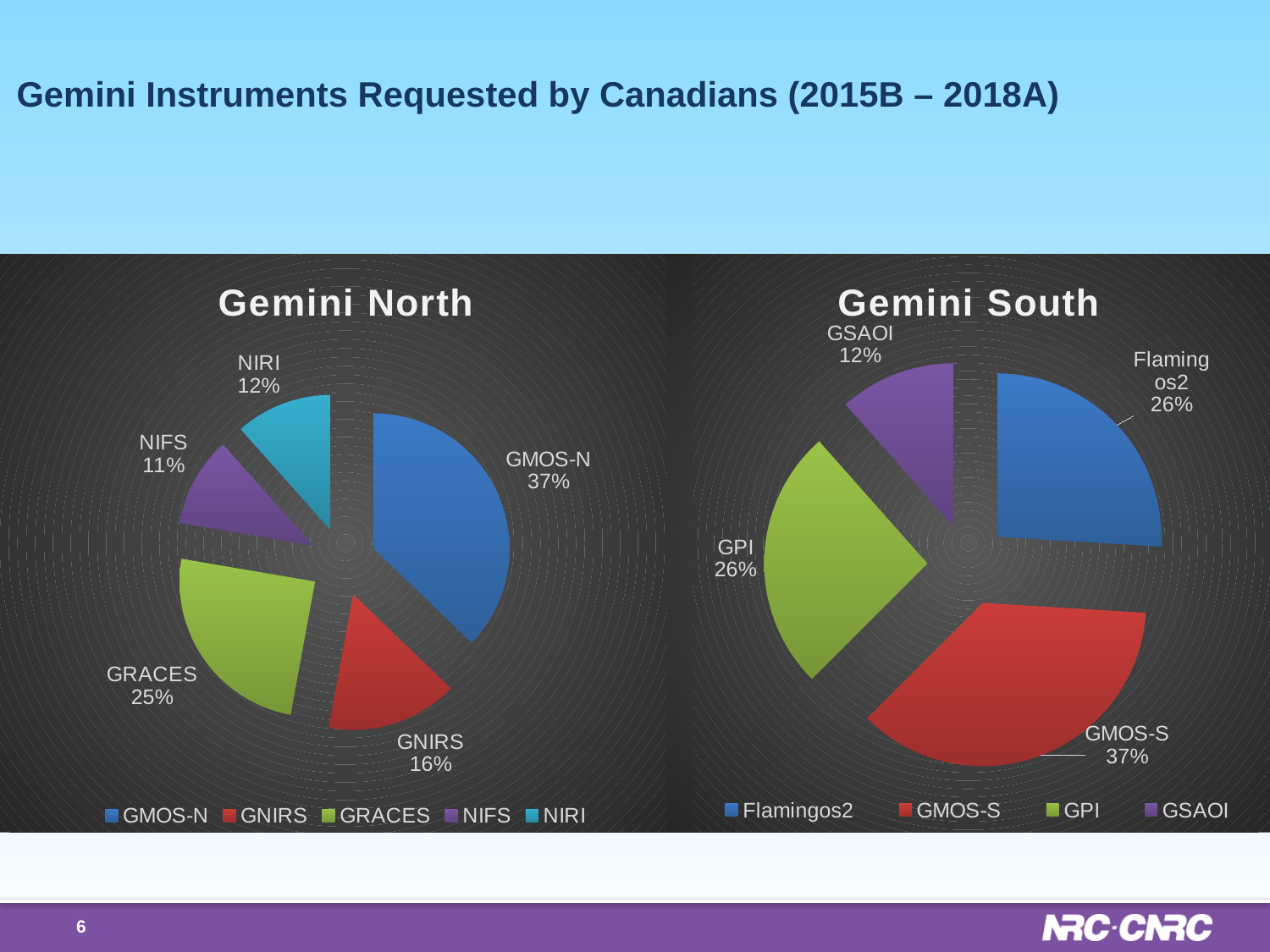
In the Gemini South chart, how many instruments does the legend list? 4 In the Gemini North chart, what share does GMOS-N have? 37% In the Gemini South chart, which instrument has the largest share? GMOS-S In the Gemini South chart, what share does GSAOI have? 12% In the Gemini North chart, what is the difference between the GMOS-N and GNIRS shares? 21% In the Gemini North chart, which instrument has the smallest share? NIFS What kind of chart is the Gemini South chart? Pie chart In the Gemini North chart, which instrument has the largest share? GMOS-N In the Gemini North chart, what share does GRACES have? 25% In the Gemini North chart, how many instruments are shown? 5 In the Gemini North chart, which is larger, the GRACES share or the GNIRS share? GRACES In the Gemini South chart, what is the difference between the GMOS-S and GPI shares? 11%